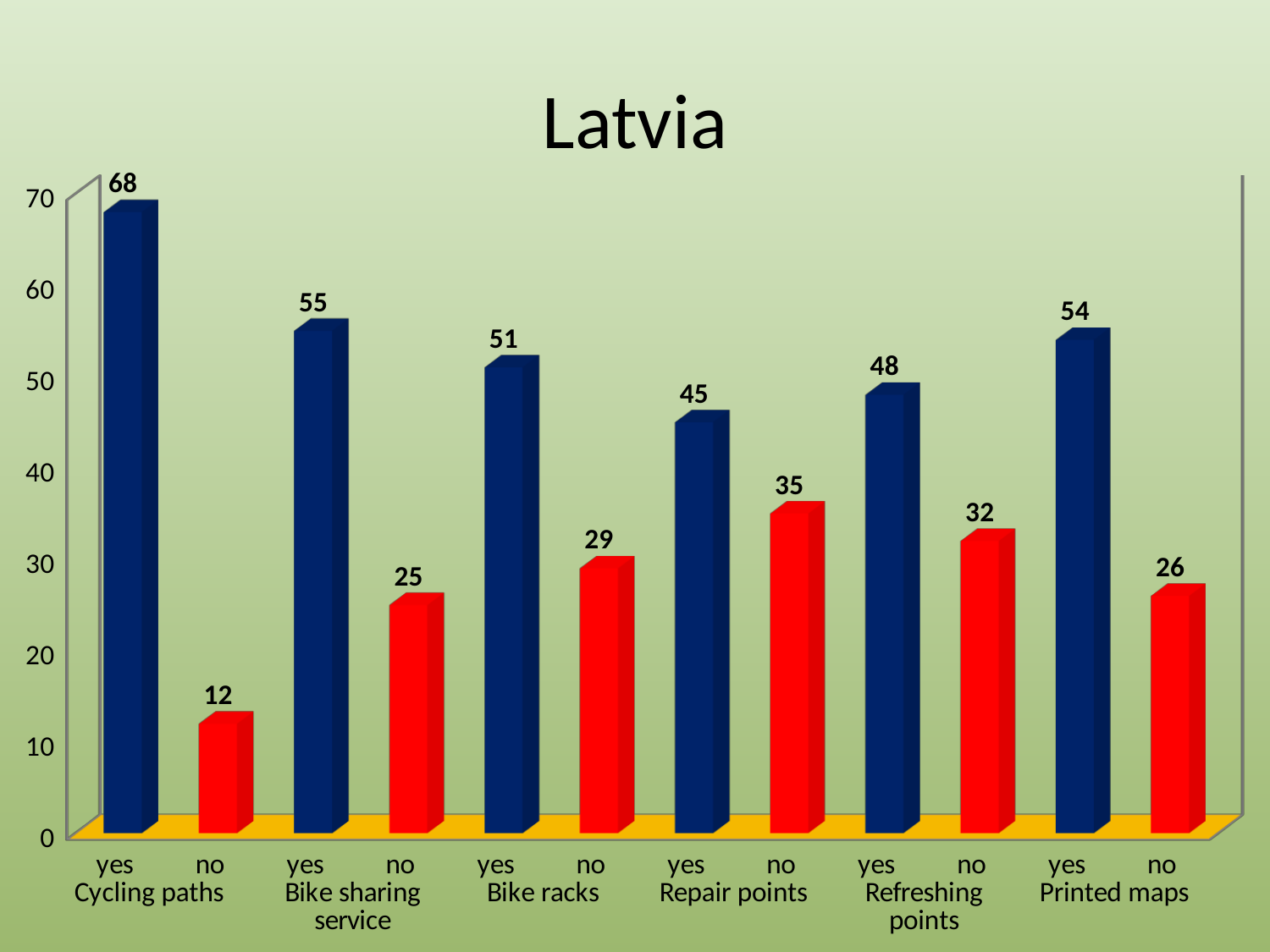
What is the value for 'yes' under Printed maps? 54 Is the 'yes' value for Repair points greater or less than 40? greater What is the difference between the 'yes' and 'no' values for Bike sharing service? 30 What is the title of the chart? Latvia Which is larger: the 'no' value for Refreshing points or the 'no' value for Bike racks? no, Refreshing points (32) What colour are the 'no' bars? red How many bars are plotted on the chart? 12 Which bar has the highest value on the chart? yes, Cycling paths (68) What is the value for 'no' under Repair points? 35 Which bar has the lowest value on the chart? no, Cycling paths (12) What kind of chart is shown on the slide? bar chart What is the value for 'yes' under Cycling paths? 68